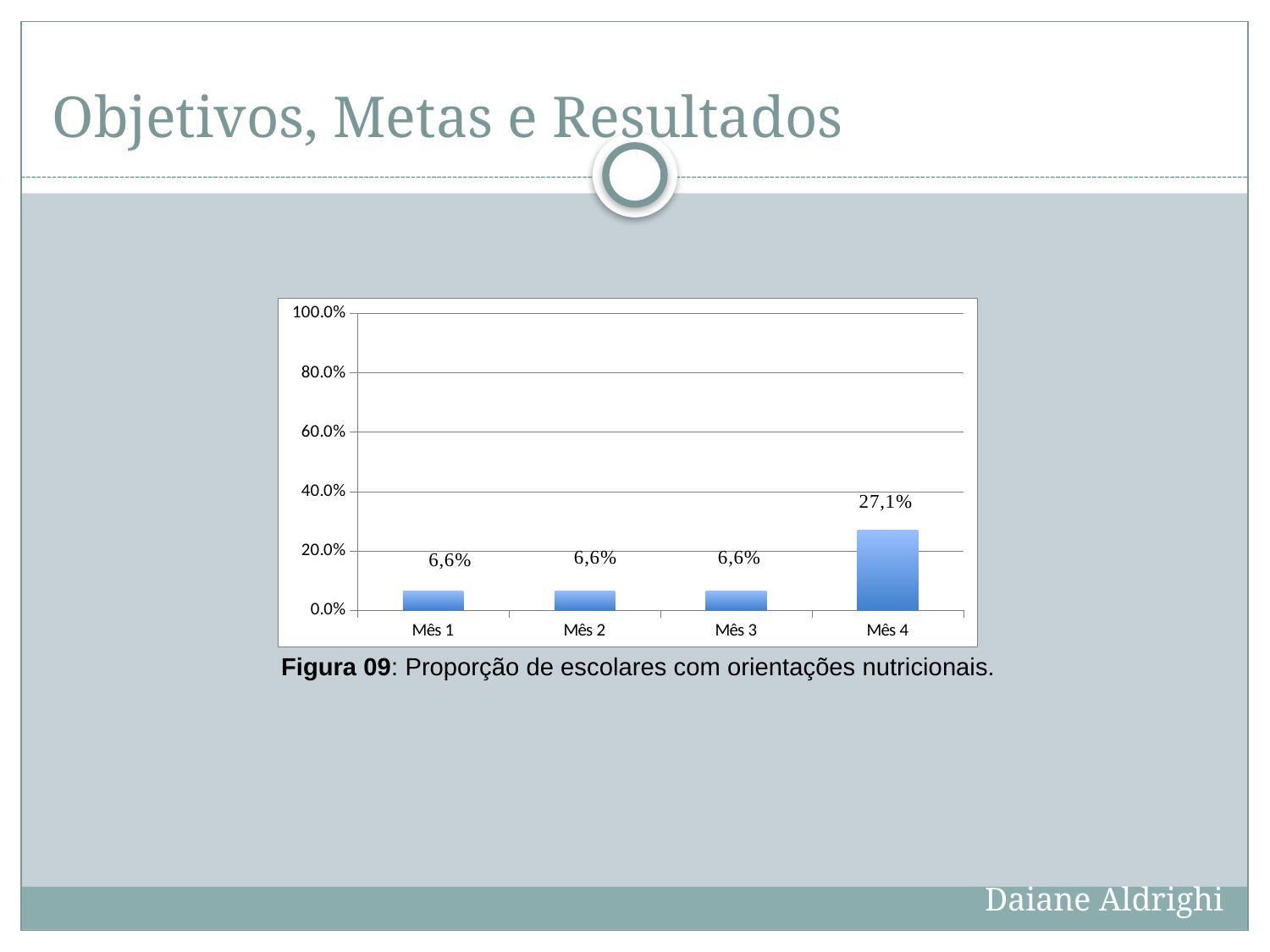
What is the value for Mês 1? 6,6% Is the value for Mês 2 greater or less than 20.0%? less Which month has the highest value? Mês 4 What is the difference between the values for Mês 4 and Mês 2? 20,5% Which is larger, the value for Mês 4 or the value for Mês 1? Mês 4 What is the figure caption below the chart? Figura 09: Proporção de escolares com orientações nutricionais. How many months are shown on the x axis? 4 What is the value for Mês 4? 27,1% Is the value for Mês 4 greater or less than 20.0%? greater What is the value for Mês 3? 6,6% What kind of chart is shown on the slide? bar chart Do the values rise or fall from Mês 3 to Mês 4? rise